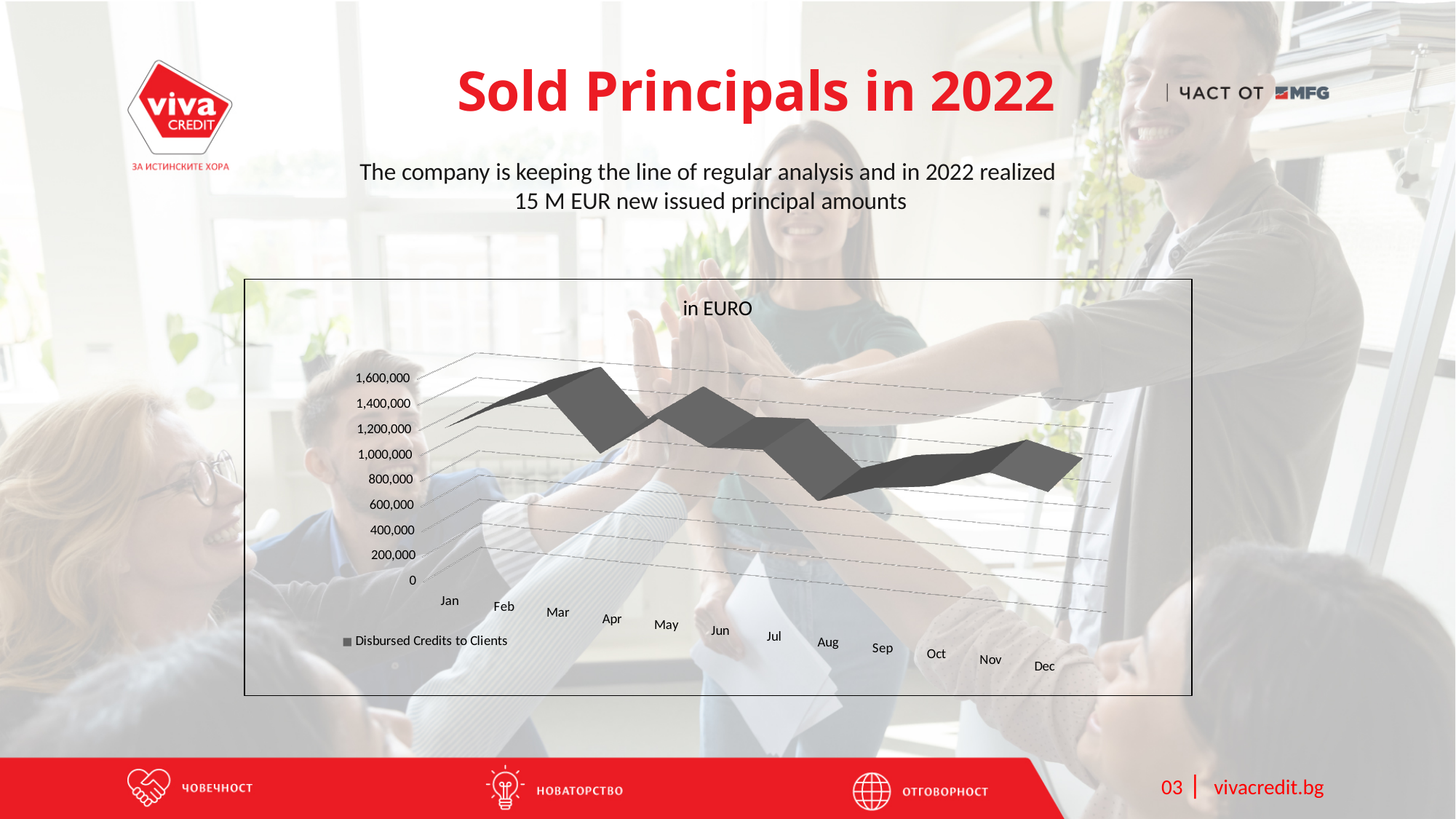
How many series does the chart legend list? 1 Which is larger, the value for Mar or the value for Sep? Mar Which month has the highest value for Disbursed Credits to Clients? Mar Is the value for Mar greater or less than 1,000,000? greater What is the name of the series shown in the chart legend? Disbursed Credits to Clients What kind of chart is shown on the slide? line chart What is the title of the chart? in EURO What is the highest value shown on the vertical axis of the chart? 1,600,000 Overall, do the values rise or fall from Jan to Dec? fall How many months are plotted on the x axis of the chart? 12 Is the value for Sep greater or less than 1,400,000? less